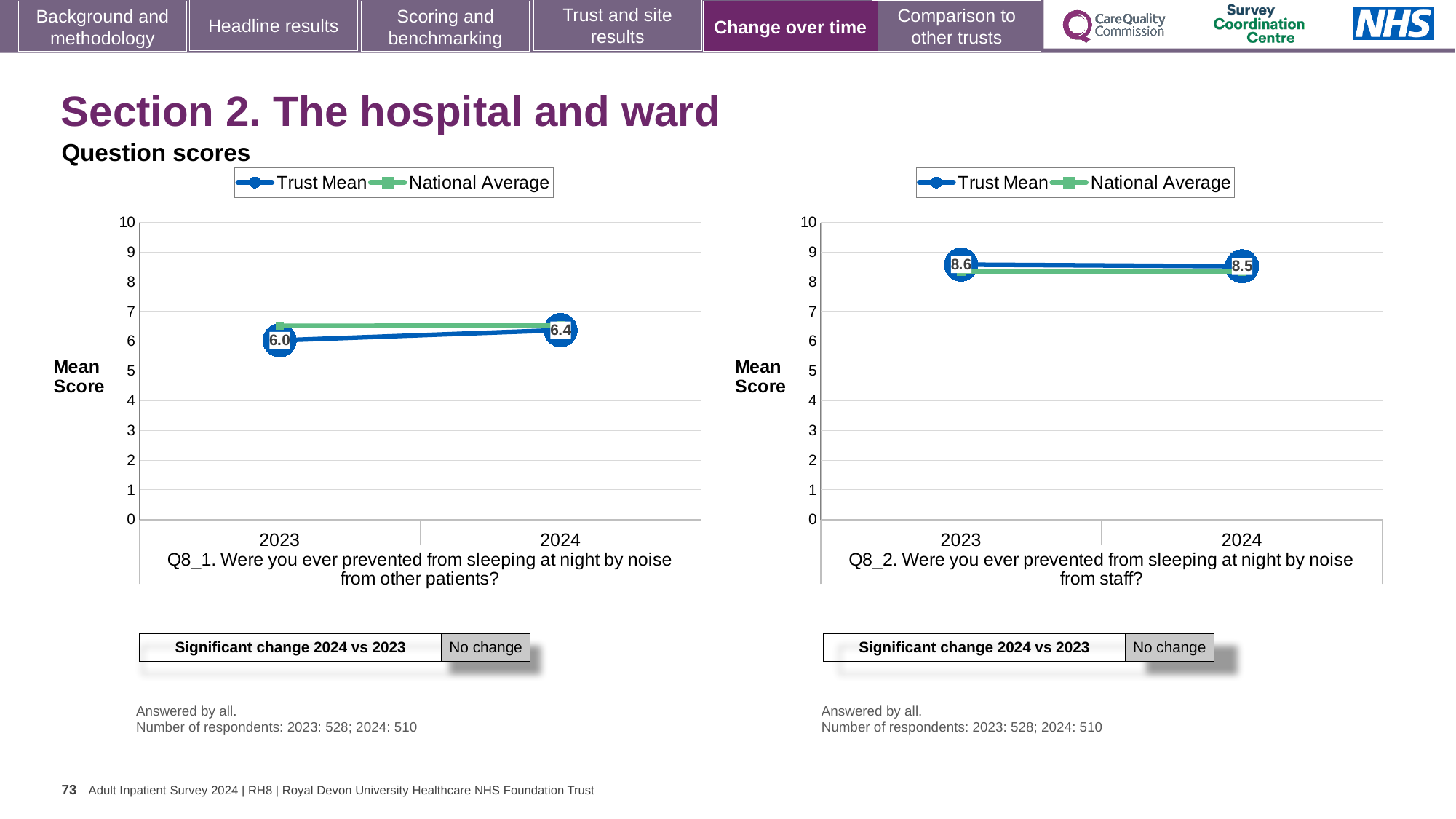
In the Q8_1 chart (left), what is the Trust Mean for 2024? 6.4 In the Q8_1 chart (left), is the National Average for 2023 greater or less than 6? greater In the Q8_2 chart (right), what is the difference between the Trust Mean in 2023 and 2024? 0.1 In the Q8_2 chart (right), is the National Average for 2024 greater or less than 9? less In the Q8_1 chart (left), what is the Trust Mean for 2023? 6.0 What kind of chart is the Q8_1 chart (left)? line chart In the Q8_1 chart (left), does the Trust Mean rise or fall from 2023 to 2024? rise In the Q8_2 chart (right), what is the Trust Mean for 2023? 8.6 In the Q8_1 chart (left), by how much did the Trust Mean change from 2023 to 2024? 0.4 In the Q8_2 chart (right), what is the Trust Mean for 2024? 8.5 In the Q8_2 chart (right), does the Trust Mean rise or fall from 2023 to 2024? fall How many series does the legend of the Q8_2 chart (right) list? 2